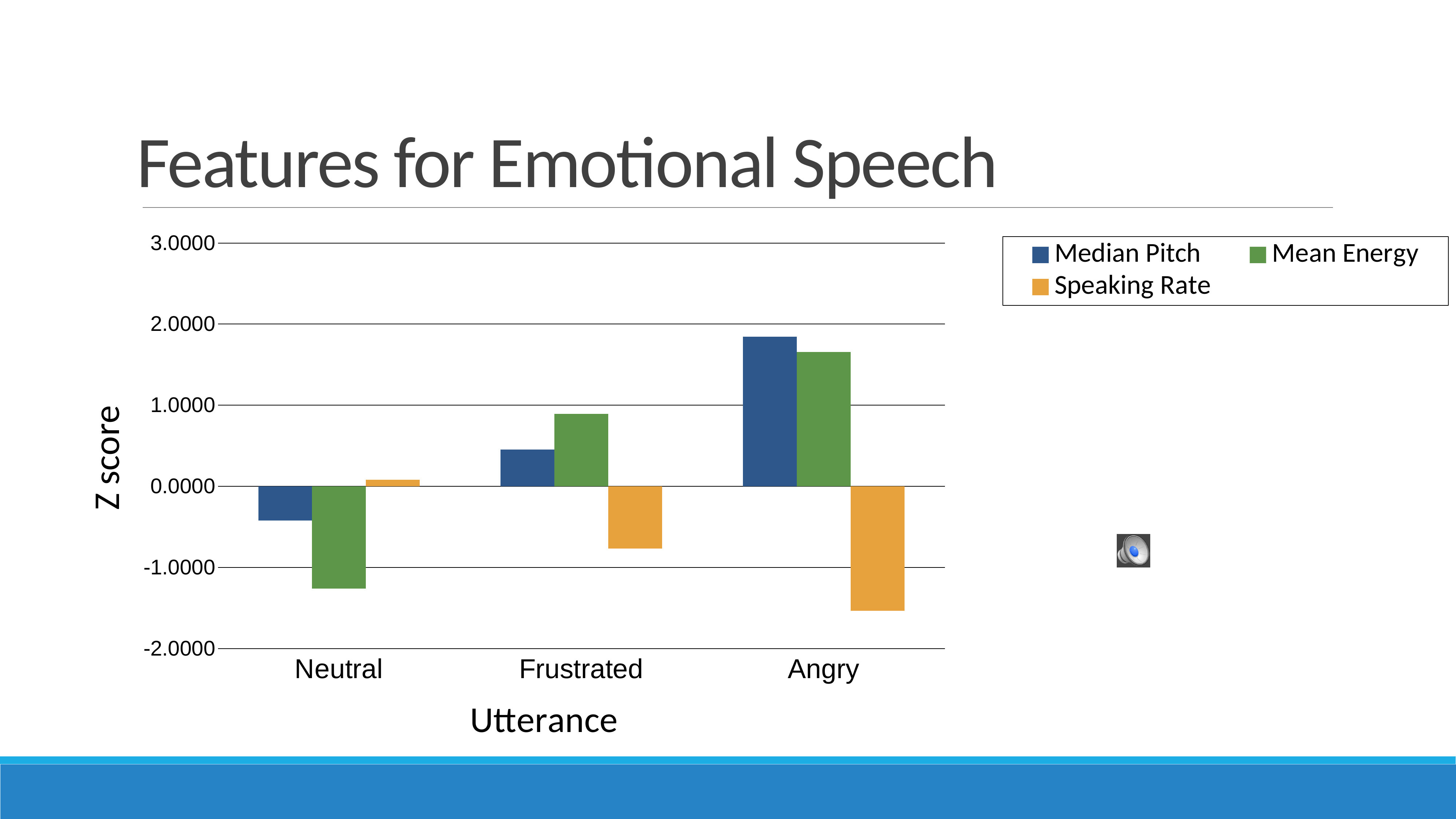
Which utterance has the highest Median Pitch z score? Angry Does the Median Pitch z score rise or fall from Neutral to Frustrated to Angry? rise Is the Mean Energy value for Angry greater or less than 1.0000? greater Is the Mean Energy value for Neutral greater or less than -1.0000? less For Frustrated, which is larger: Median Pitch or Mean Energy? Mean Energy How many utterance categories are shown on the x axis? 3 Which utterance has the lowest Speaking Rate z score? Angry What kind of chart is shown on the slide? bar chart Is the Speaking Rate value for Angry greater or less than -1.0000? less What is the title of the y axis? Z score Which utterance has the lowest Mean Energy z score? Neutral How many series does the legend list? 3